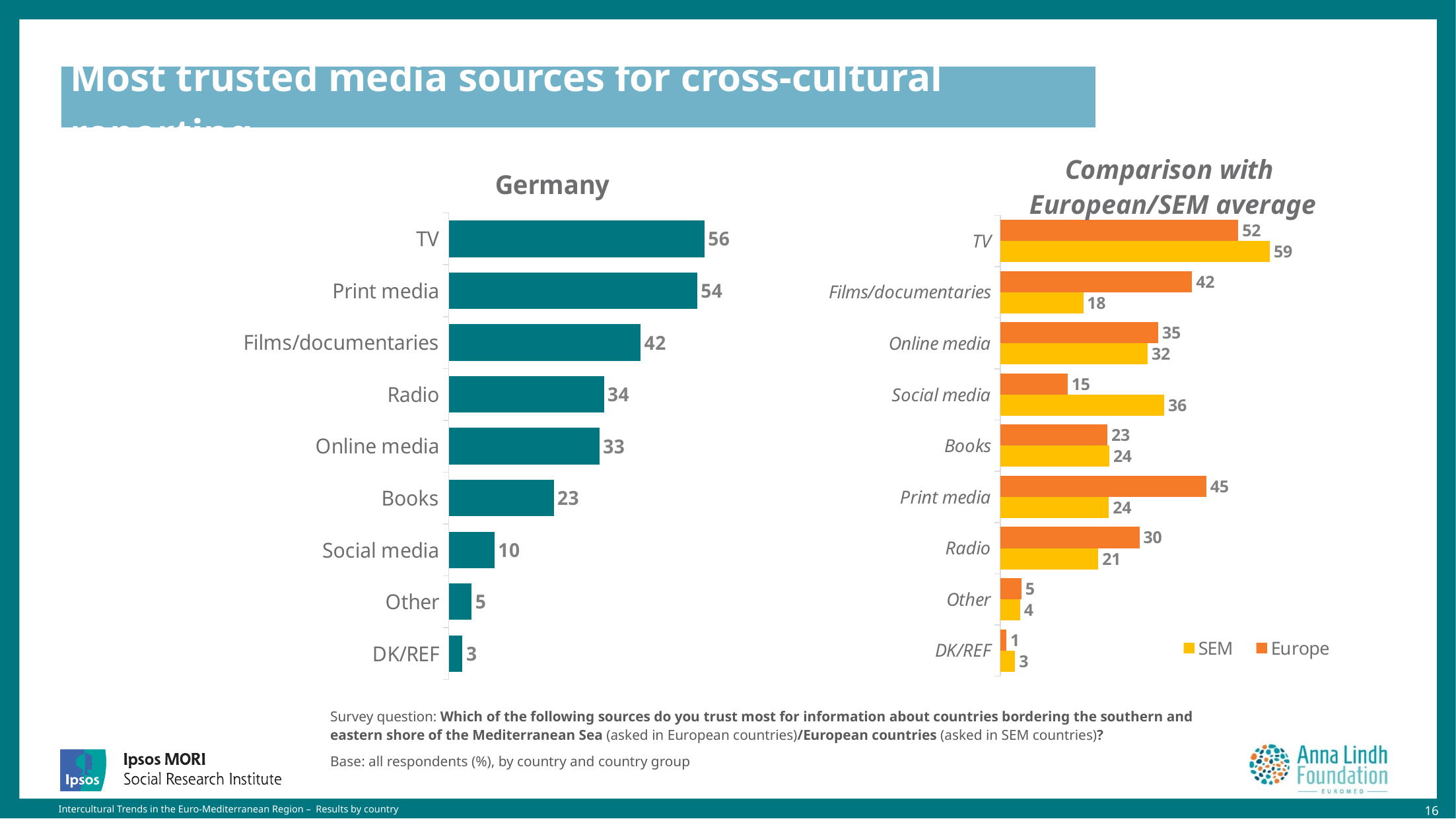
In the Germany chart, which category has the lowest value? DK/REF In the Germany chart, what is the difference between the values for TV and Social media? 46 In the Comparison with European/SEM average chart, which is larger for Print media: the Europe value or the SEM value? Europe In the Comparison with European/SEM average chart, what is the Europe value for Films/documentaries? 42 How many series does the legend of the Comparison with European/SEM average chart list? 2 In the Comparison with European/SEM average chart, what is the difference between the Europe and SEM values for Radio? 9 What kind of chart is the Germany chart? Bar chart In the Germany chart, what is the value for Print media? 54 In the Comparison with European/SEM average chart, what is the SEM value for Social media? 36 In the Germany chart, how many categories are shown? 9 In the Comparison with European/SEM average chart, which colour represents the SEM series? Yellow In the Germany chart, which category has the highest value? TV